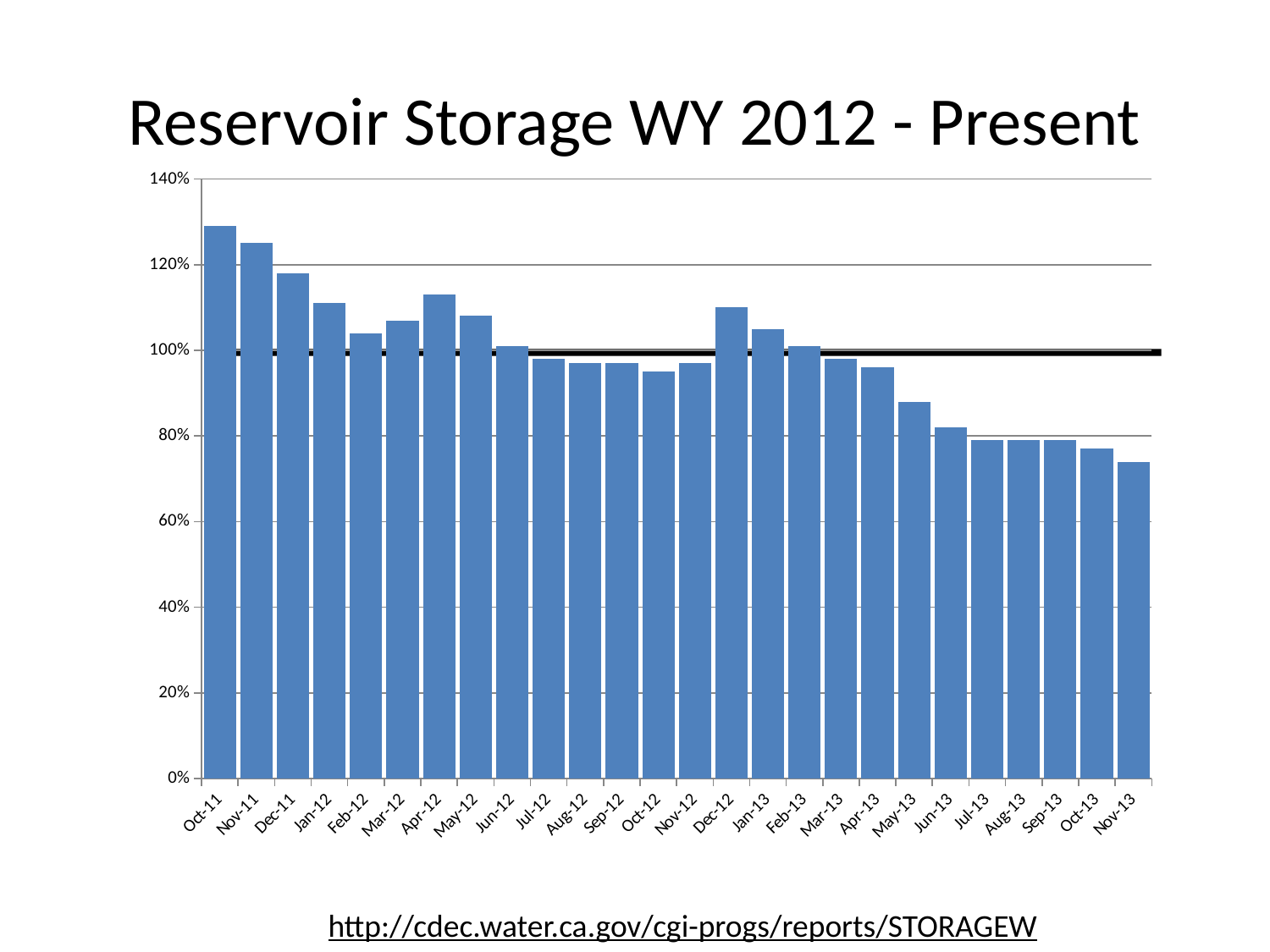
Is the value for Apr-12 greater or less than 100%? greater What kind of chart is shown on the slide? bar chart Is the value for Oct-11 greater or less than 120%? greater Is the value for Nov-13 greater or less than 80%? less At what percentage level is the thick horizontal reference line drawn across the chart? 100% Which month has the lowest reservoir storage value? Nov-13 Overall, do the values rise or fall from Oct-11 to Nov-13? fall What is the title of the chart? Reservoir Storage WY 2012 - Present Which is larger, the value for Dec-12 or the value for Nov-12? Dec-12 Which month has the highest reservoir storage value? Oct-11 How many months (bars) are plotted on the chart? 26